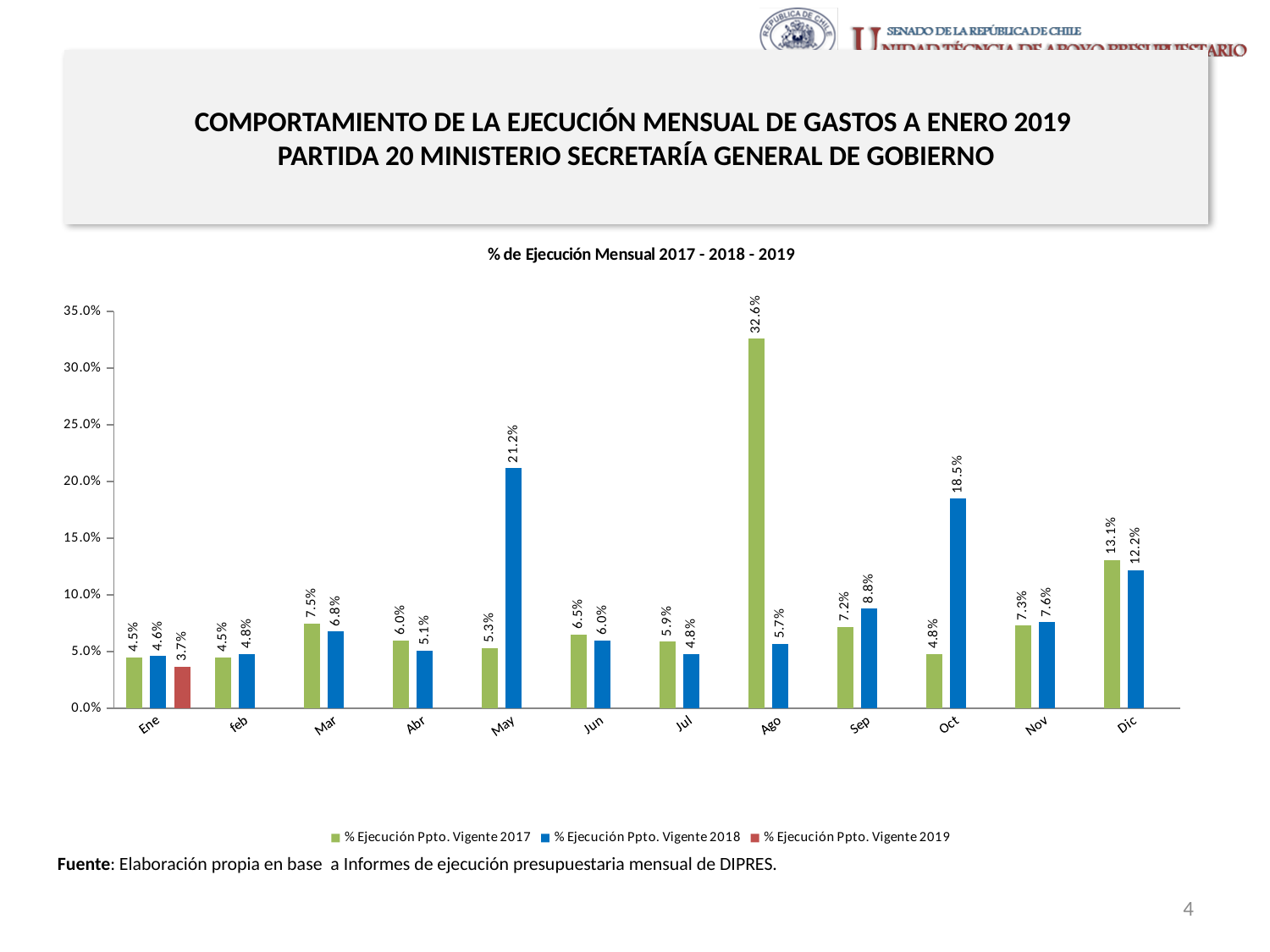
How many series does the legend list? 3 Which month has the highest % Ejecución Ppto. Vigente 2018 value? May How many months are shown on the x axis? 12 What kind of chart is shown? Bar chart Which month has the highest % Ejecución Ppto. Vigente 2017 value? Ago What is the % Ejecución Ppto. Vigente 2019 value for Ene? 3.7% What is the difference between the 2018 and 2017 values for Oct? 13.7% What is the title of the chart? % de Ejecución Mensual 2017 - 2018 - 2019 Which is larger for Sep: the 2017 value or the 2018 value? 2018 (8.8%) What is the % Ejecución Ppto. Vigente 2018 value for May? 21.2% What is the % Ejecución Ppto. Vigente 2017 value for Dic? 13.1% Is the % Ejecución Ppto. Vigente 2017 value for Ago greater or less than 30.0%? greater